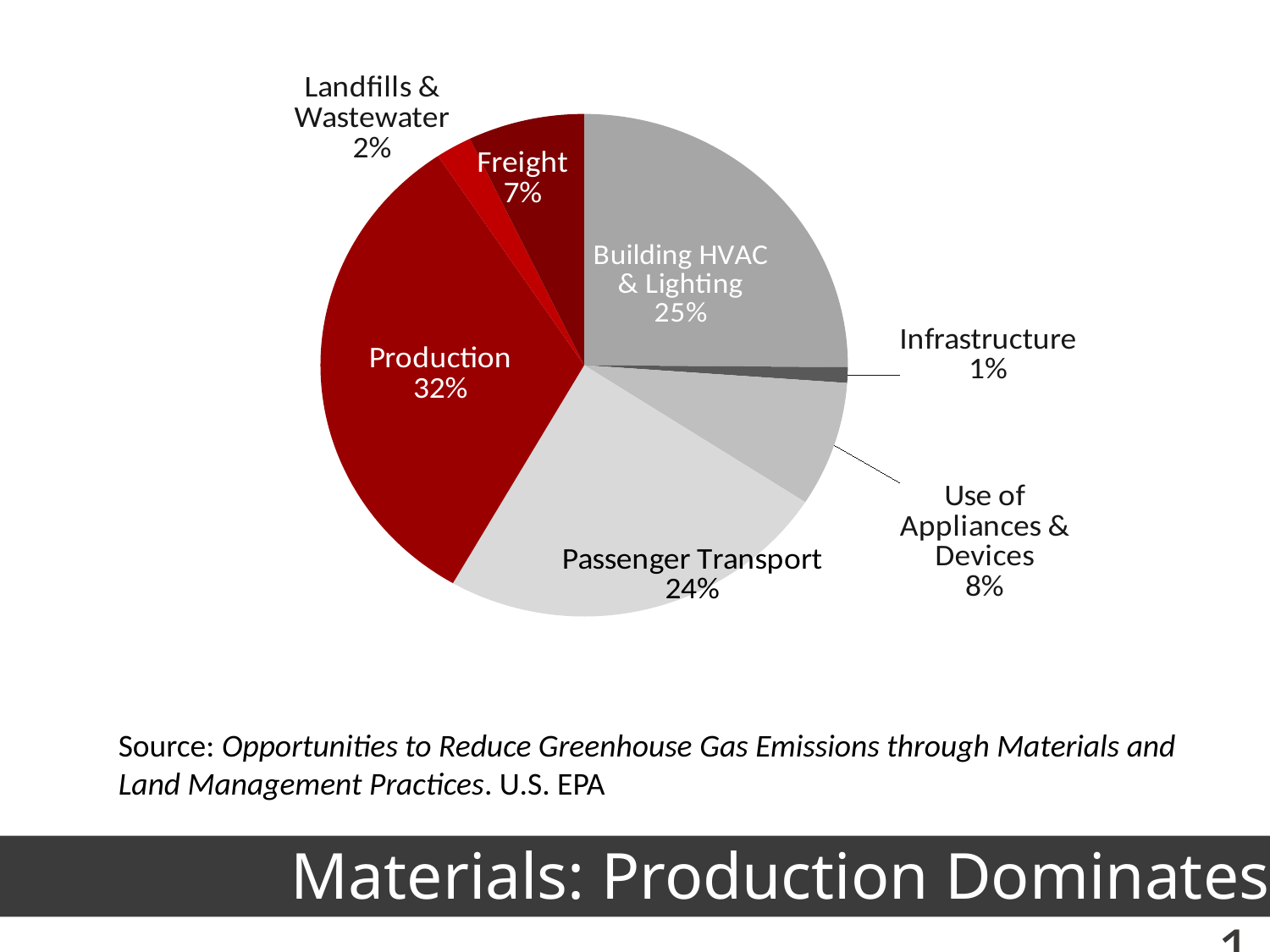
How many categories are shown in the pie chart? 7 What share of the pie does Production account for? 32% What is the value for Passenger Transport? 24% Which is larger, Freight or Use of Appliances & Devices? Use of Appliances & Devices What percentage is shown for Building HVAC & Lighting? 25% What kind of chart is shown on the slide? Pie chart What is the difference in percentage points between Production and Passenger Transport? 8 Which category has the smallest slice of the pie? Infrastructure What is the combined share of Landfills & Wastewater and Infrastructure? 3% What percentage is labelled for Use of Appliances & Devices? 8% What is the value for Freight? 7% Which category has the largest slice of the pie? Production